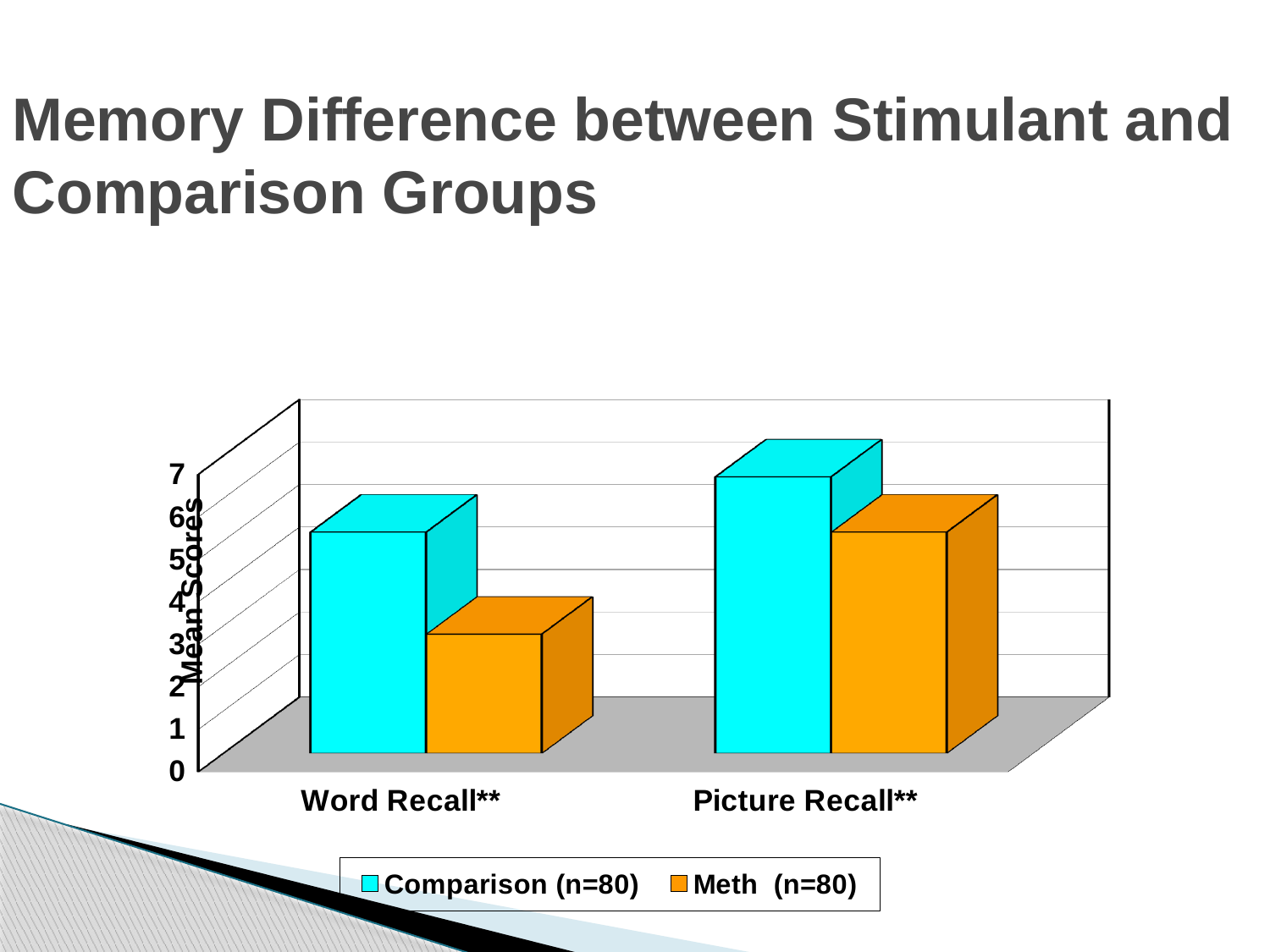
What is the title of the chart's vertical axis? Mean Scores Is the mean score for Meth (n=80) on Word Recall** greater or less than 4? less Which bar is the lowest in the chart? Meth (n=80), for Word Recall** Do the mean scores for the Meth (n=80) group rise or fall from Word Recall** to Picture Recall**? Rise Which series has the highest bar in the chart? Comparison (n=80), for Picture Recall** Is the mean score for Comparison (n=80) on Picture Recall** greater or less than 6? greater What kind of chart is shown on the slide? Bar chart Is the mean score for Meth (n=80) on Picture Recall** greater or less than 4? greater For Picture Recall**, which group has the larger mean score, Comparison (n=80) or Meth (n=80)? Comparison (n=80) For Word Recall**, which group has the larger mean score, Comparison (n=80) or Meth (n=80)? Comparison (n=80) How many series does the chart's legend list? 2 How many categories are shown on the x axis of the chart? 2